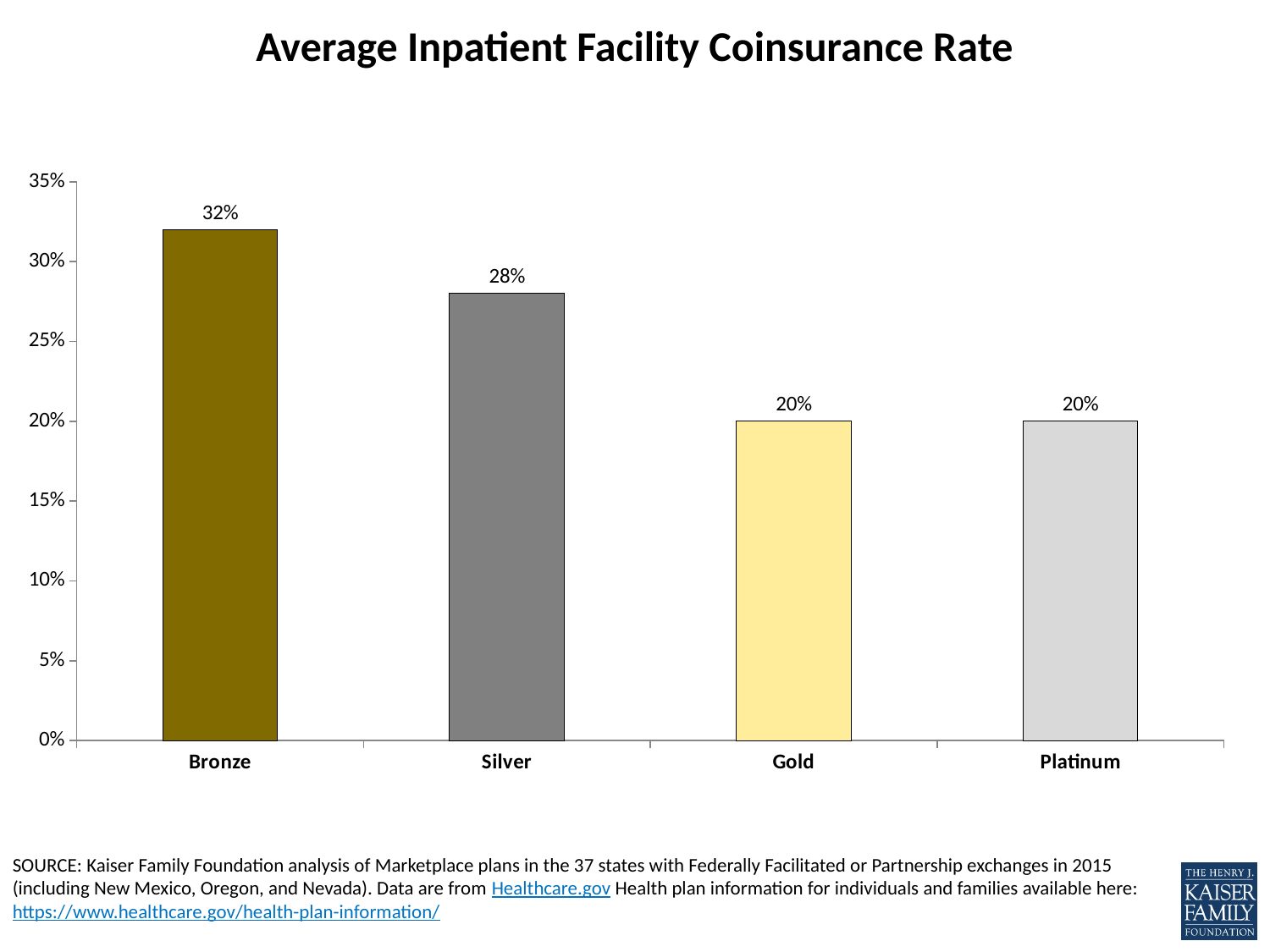
What is the average inpatient facility coinsurance rate for Platinum plans? 20% What is the average inpatient facility coinsurance rate for Gold plans? 20% What is the average inpatient facility coinsurance rate for Bronze plans? 32% How many plan tiers are shown on the chart? 4 What is the title of the chart? Average Inpatient Facility Coinsurance Rate Which plan tier has the highest average inpatient facility coinsurance rate? Bronze What is the average inpatient facility coinsurance rate for Silver plans? 28% What is the difference between the Silver and Gold average inpatient facility coinsurance rates? 8% Is the value for Silver greater or less than 25%? greater What is the difference between the Bronze and Silver average inpatient facility coinsurance rates? 4% What kind of chart is shown on the slide? Bar chart Which has a higher average inpatient facility coinsurance rate, Bronze or Silver? Bronze